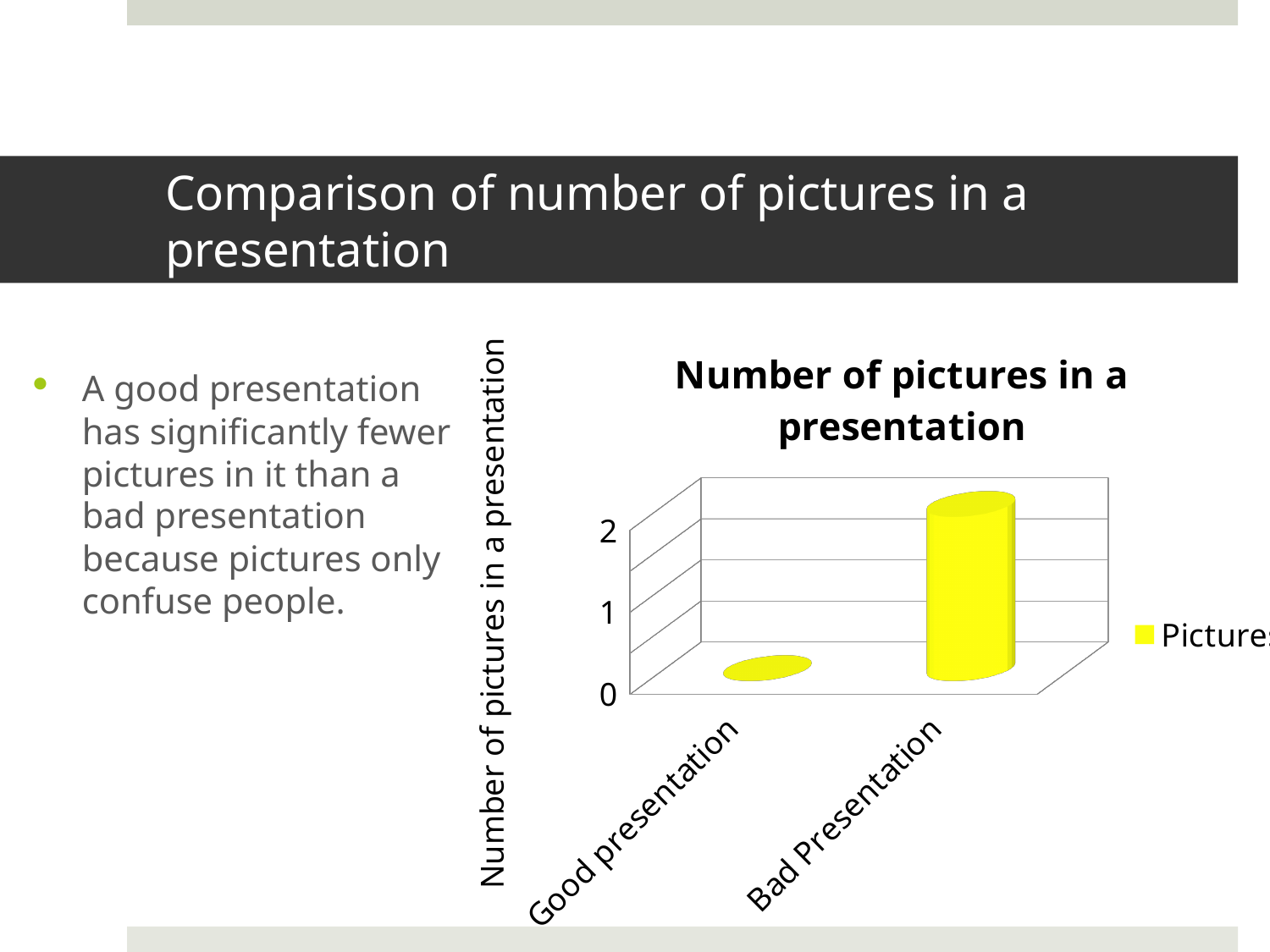
Is the value for Good presentation greater or less than 1? less What is the title of the chart? Number of pictures in a presentation What kind of chart is shown on the slide? bar chart How many categories are plotted on the x axis of the chart? 2 Which has the larger value, Good presentation or Bad Presentation? Bad Presentation Do the values rise or fall moving from Good presentation to Bad Presentation along the x axis? rise How many series does the chart's legend list? 1 Is the value for Bad Presentation greater or less than 1? greater Which category has the highest value in the chart? Bad Presentation Which category has the lowest value in the chart? Good presentation What is the label on the vertical axis of the chart? Number of pictures in a presentation